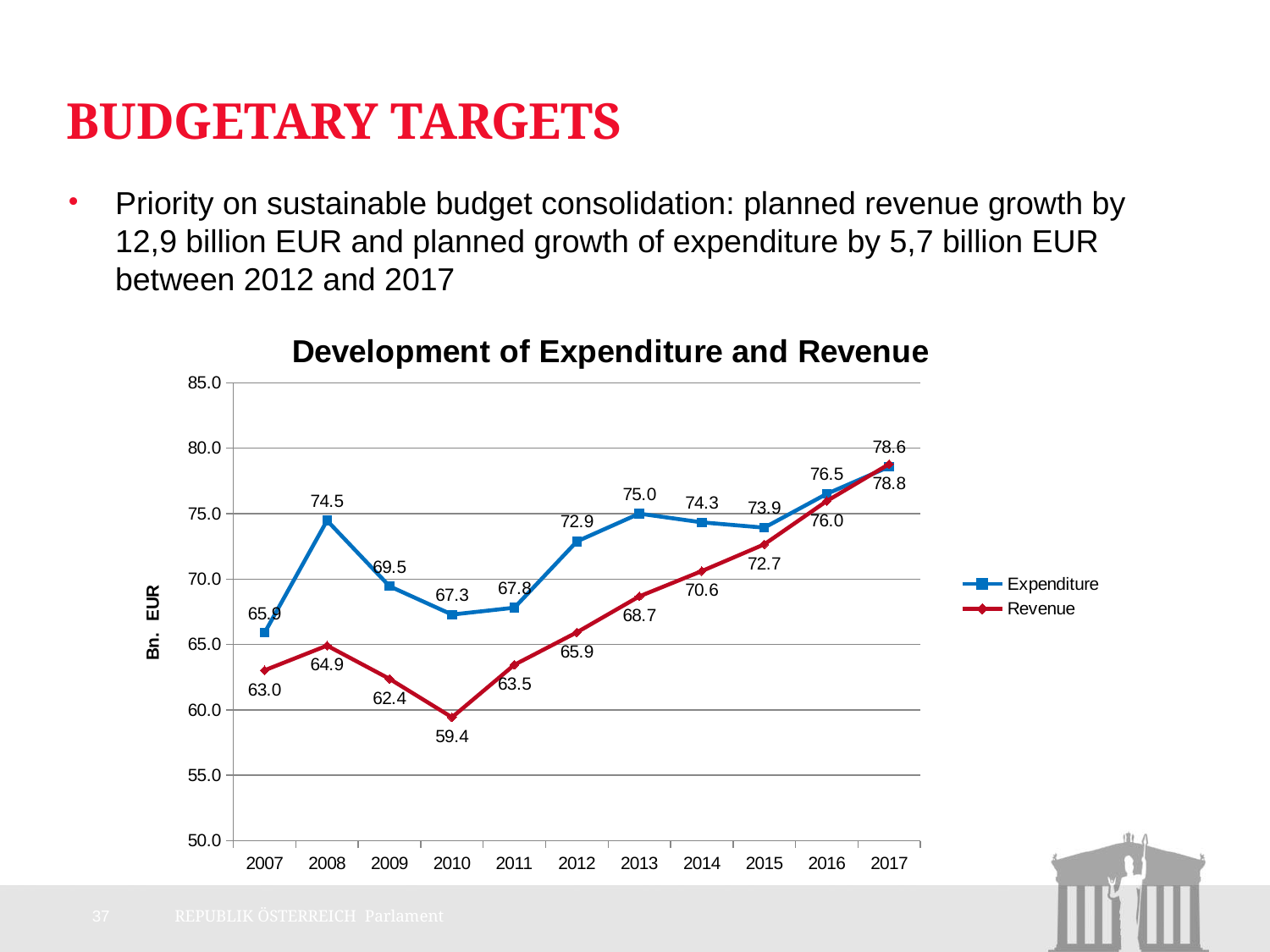
What is the Revenue value for 2015? 72.7 In which year is Revenue lowest? 2010 What is the Expenditure value for 2008? 74.5 How many series does the legend list? 2 Is the Revenue value for 2009 greater or less than 65.0? less What is the difference between Expenditure and Revenue in 2012? 7.0 In which year is Expenditure highest? 2017 How many years are shown on the x axis? 11 What is the Revenue value for 2010? 59.4 What kind of chart is shown? line chart Which is larger in 2013, Expenditure or Revenue? Expenditure Does Revenue rise or fall from 2010 to 2017? rise